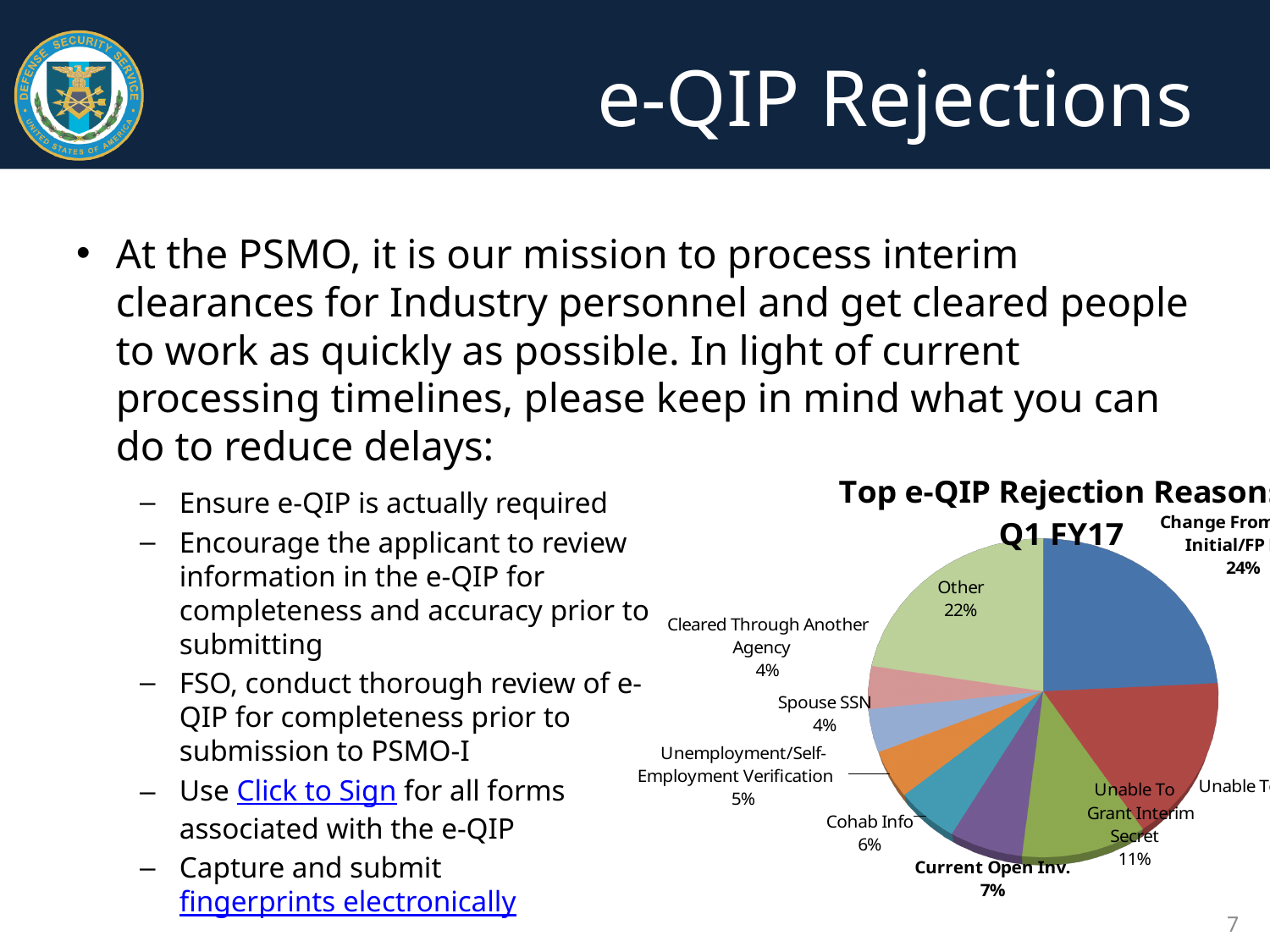
What percentage is shown for Unemployment/Self-Employment Verification? 5% What kind of chart is shown on the slide? Pie chart What percentage is shown for Cohab Info? 6% How many percentage points larger is the Change From Initial/FP slice than the Other slice? 2 How many slices does the pie chart have? 9 Which labelled rejection reason has the largest share of the pie? Change From Initial/FP What percentage is shown for Unable To Grant Interim Secret? 11% What percentage is shown for Spouse SSN? 4% Which is larger, the Cohab Info slice or the Unemployment/Self-Employment Verification slice? Cohab Info What percentage of e-QIP rejections is attributed to Change From Initial/FP? 24% What share of the pie is labelled Other? 22% What percentage is shown for Current Open Inv.? 7%